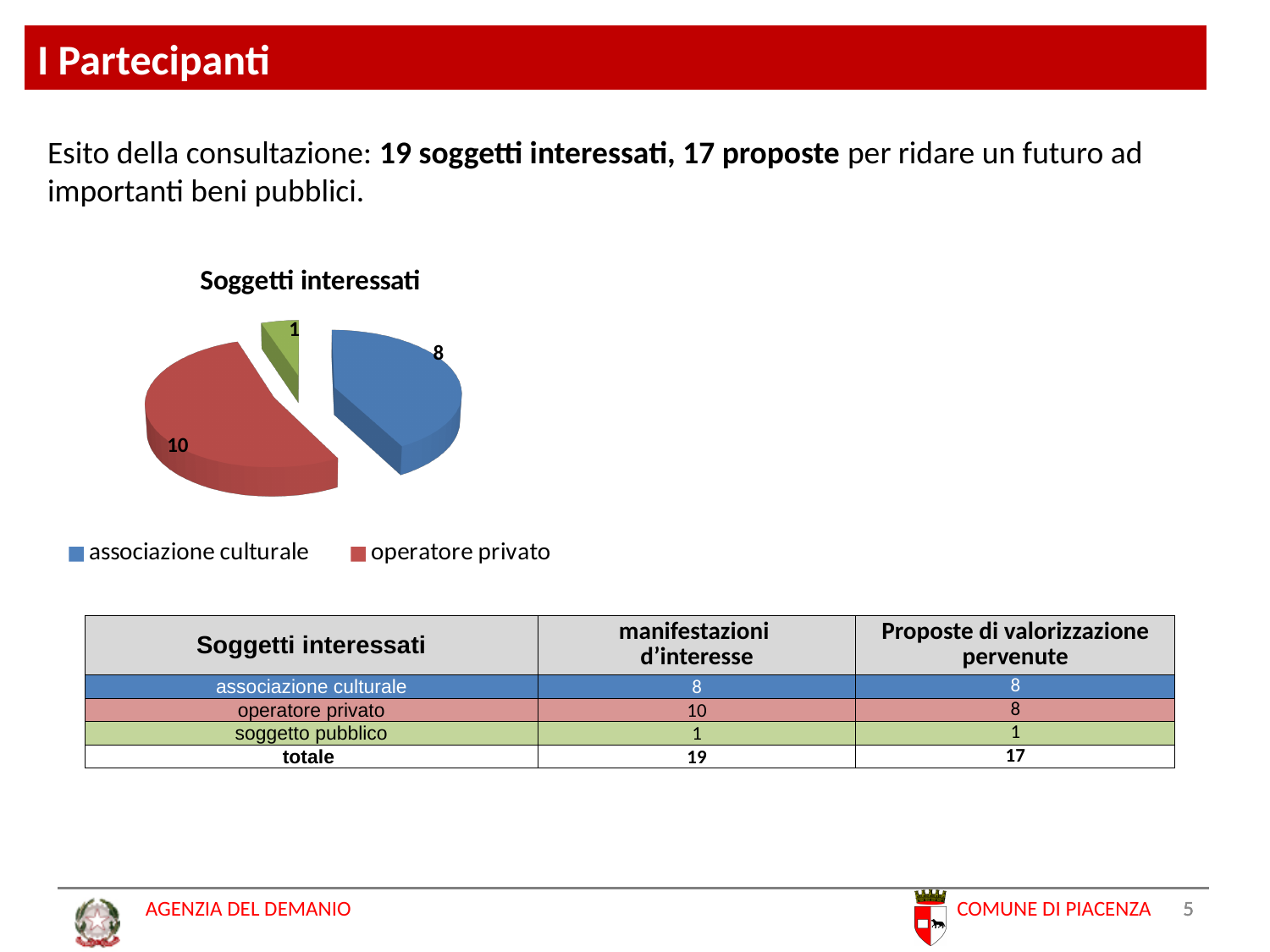
What is the value of the associazione culturale slice in the pie chart? 8 What is the value of the green slice in the pie chart? 1 What is the value of the operatore privato slice in the pie chart? 10 What is the title of the chart? Soggetti interessati What is the difference between the operatore privato slice and the associazione culturale slice? 2 What kind of chart is shown on the slide? pie chart How many slices does the pie chart have? 3 Which category has the largest slice in the pie chart? operatore privato How many entries does the chart legend list? 2 Which is larger in the pie chart, associazione culturale or operatore privato? operatore privato What is the total of all the slice values in the pie chart? 19 What is the value of the smallest slice in the pie chart? 1